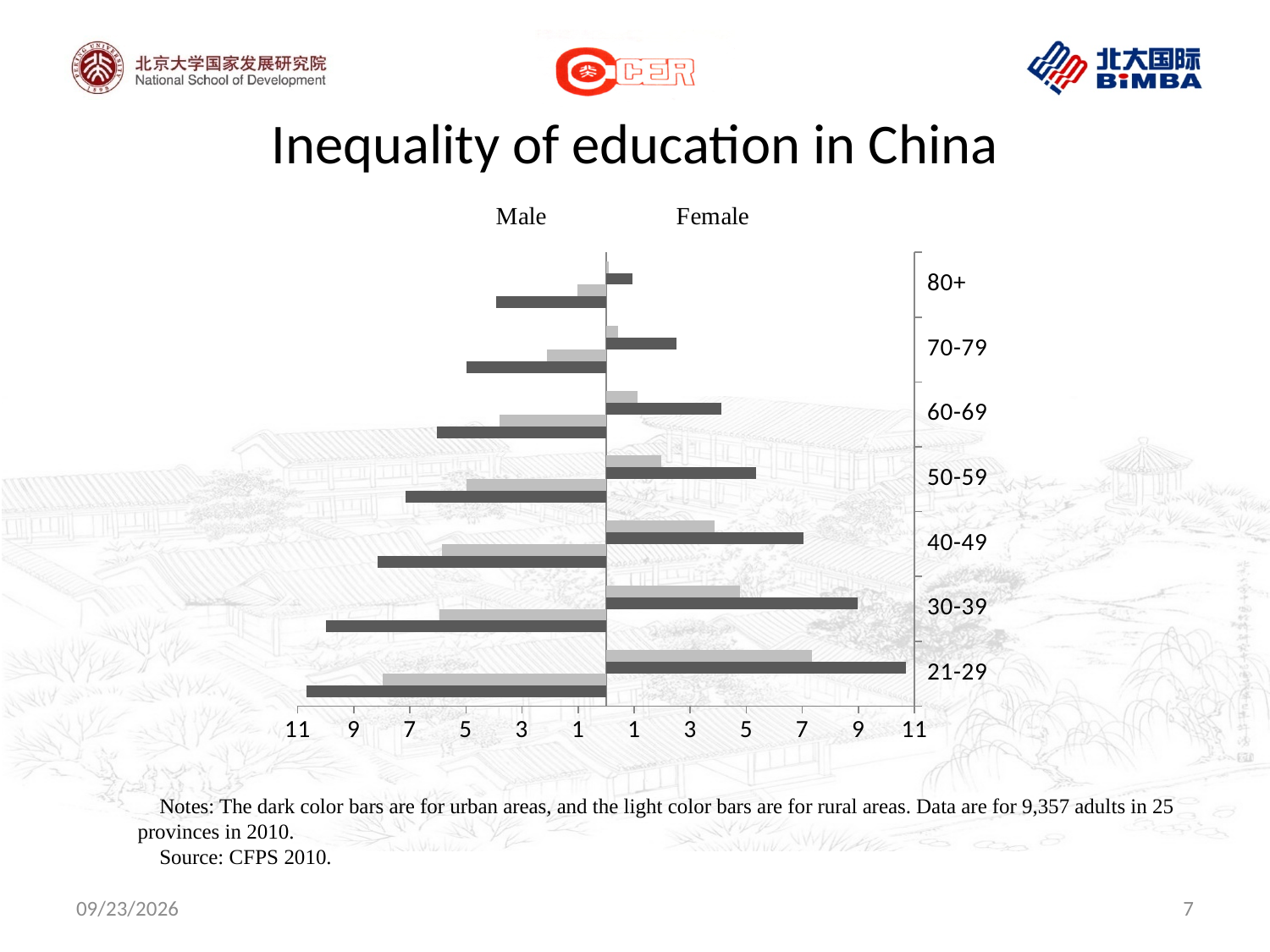
Is the value of the female rural (light) bar for the 21-29 age group greater or less than 5? greater For the 50-59 age group, which urban (dark) bar is longer, male or female? male Moving from the 80+ age group down to the 21-29 age group, do the male urban (dark) bars get longer or shorter? longer Is the value of the female urban (dark) bar for the 60-69 age group greater or less than 5? less Is the value of the male urban (dark) bar for the 21-29 age group greater or less than 9? greater What is the title of the chart on the slide? Inequality of education in China How many age groups are shown on the chart? 7 Which age group has the shortest male urban (dark) bar? 80+ According to the notes, what do the dark color bars represent? urban areas What kind of chart is shown on the slide? bar chart Which age group has the longest female urban (dark) bar? 21-29